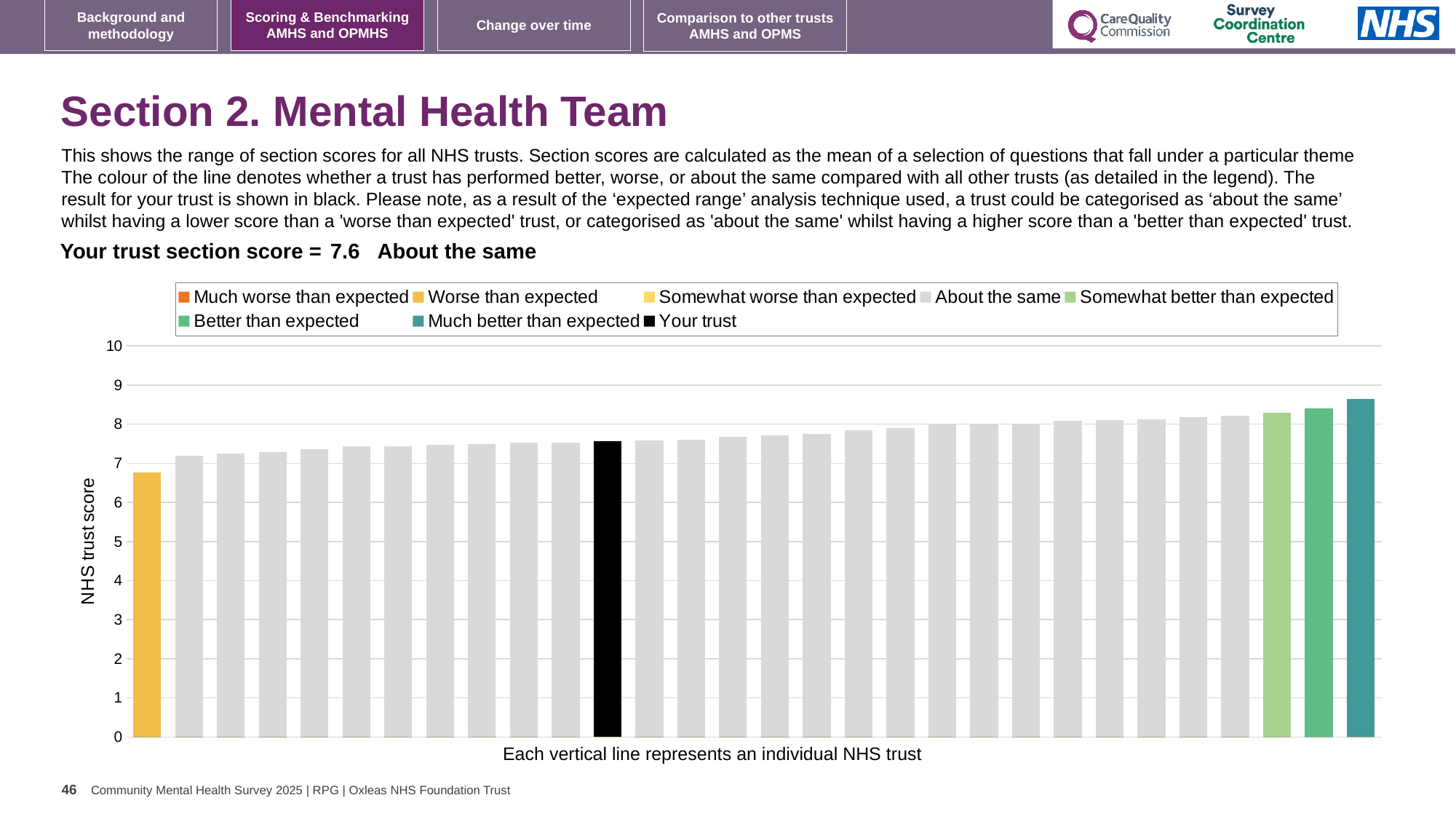
Do the bar values rise or fall from left to right across the chart? rise Which legend category does the lowest bar belong to? Worse than expected How many bars (NHS trusts) are plotted in the chart? 30 How many entries does the chart legend list? 8 What category is the trust's section score placed in, according to the text above the chart? About the same Which legend category does the highest bar belong to? Much better than expected Is the value of the black 'Your trust' bar greater or less than 7? greater What kind of chart is shown on the slide? bar chart Is the value of the rightmost (highest) bar greater or less than 8? greater Is the value of the leftmost (lowest) bar greater or less than 7? less What is the label on the vertical axis of the chart? NHS trust score What is the trust section score shown on the slide? 7.6